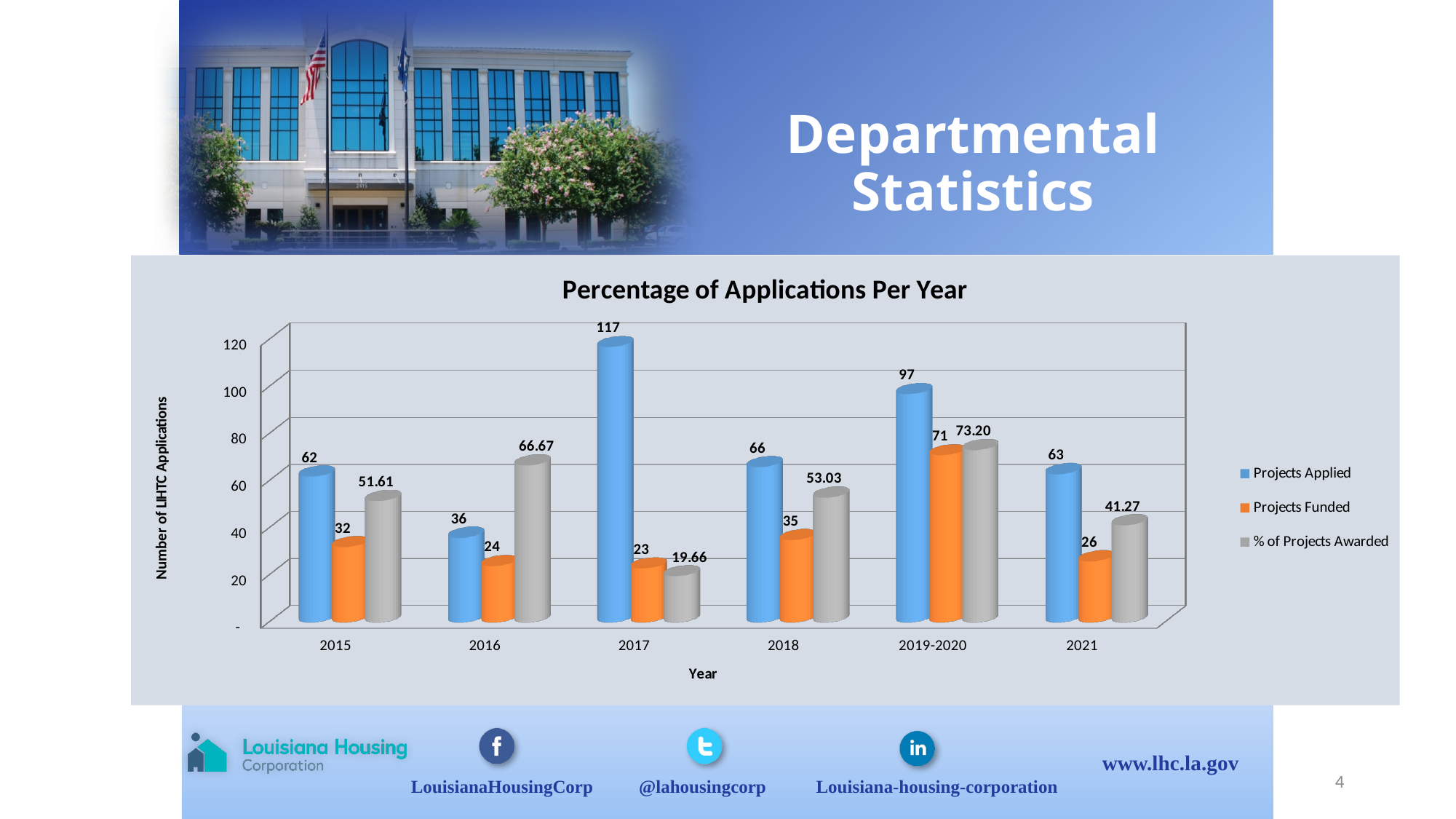
How many year categories are shown on the x axis? 6 What kind of chart is shown on the slide? Bar chart Which year has the lowest % of Projects Awarded? 2017 Which year has the highest value for Projects Applied? 2017 What is the value of Projects Funded for 2019-2020? 71 What is the difference between Projects Applied and Projects Funded in 2018? 31 What is the % of Projects Awarded for 2016? 66.67 What is the label of the vertical axis? Number of LIHTC Applications What is the value of Projects Applied for 2017? 117 What is the title of the chart? Percentage of Applications Per Year How many series does the legend list? 3 Which is larger: Projects Funded in 2015 or Projects Funded in 2021? Projects Funded in 2015